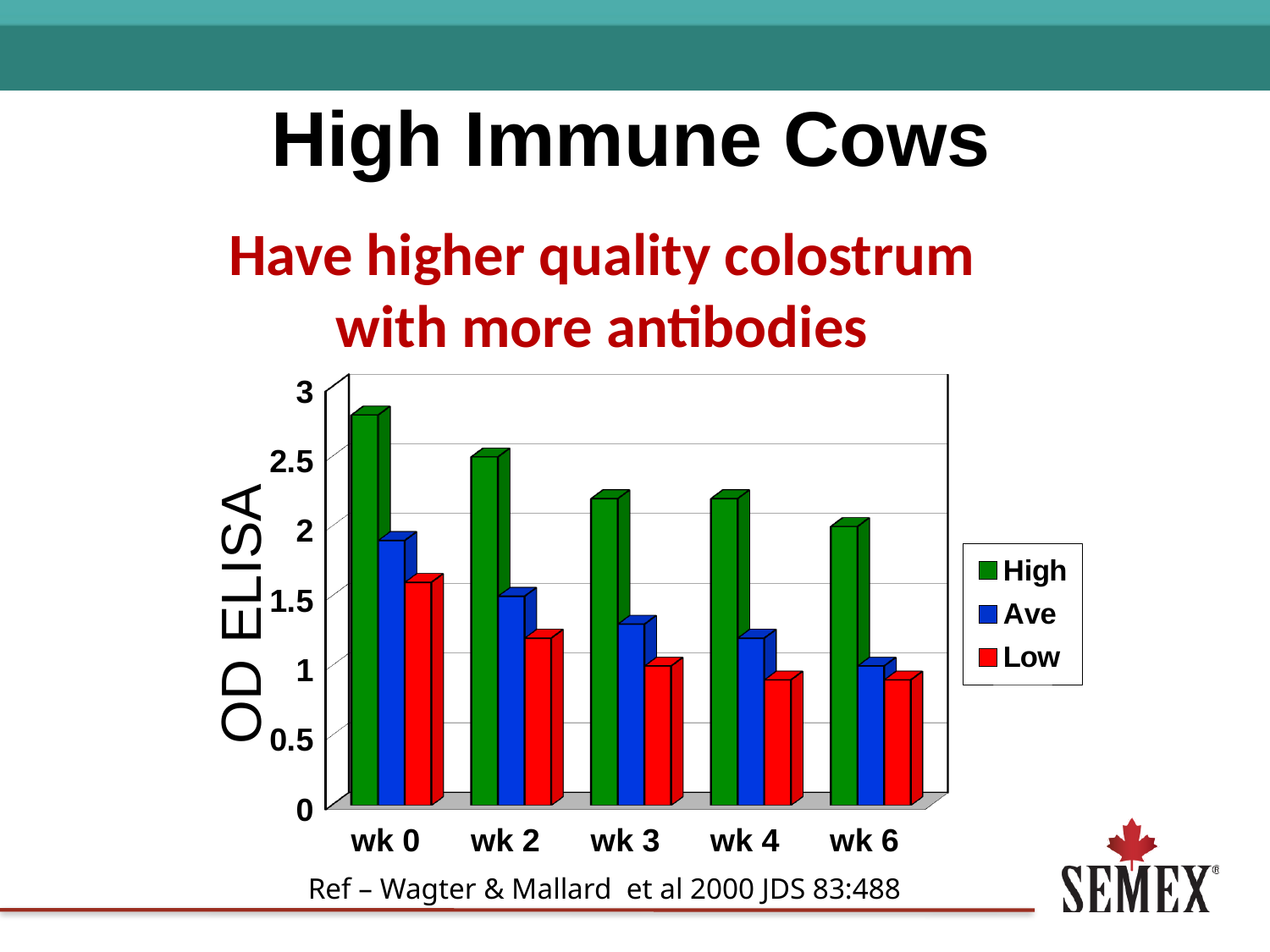
At which week is the High series at its highest? wk 0 Which colour represents the Low series in the legend? red Is the value for Ave at wk 0 greater or less than 1.5? greater Does the High series rise or fall from wk 0 to wk 6? fall Is the value for Low at wk 2 greater or less than 1.5? less What is the label on the vertical axis? OD ELISA Is the value for High at wk 3 greater or less than 2.5? less How many week categories are shown on the x axis? 5 What kind of chart is shown on the slide? bar chart How many series does the legend list? 3 At which week is the Ave series at its lowest? wk 6